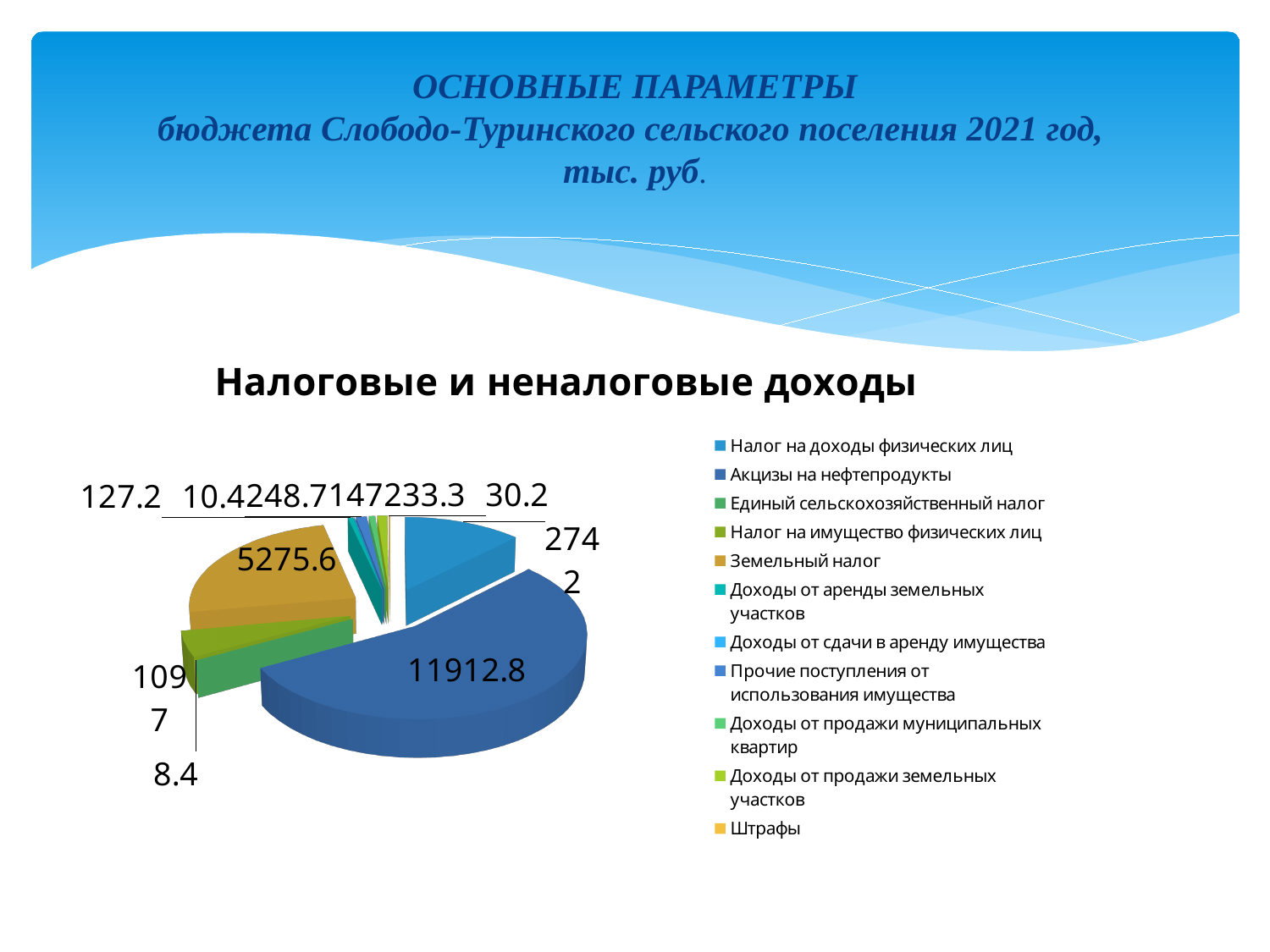
What is the value for Налог на доходы физических лиц? 2742 Which category has the largest slice of the pie? Акцизы на нефтепродукты How many categories does the chart legend list? 11 What is the difference between Земельный налог and Налог на доходы физических лиц? 2533.6 What is the largest value shown on the pie chart? 11912.8 What kind of chart is shown on the slide? Pie chart What is the value for Акцизы на нефтепродукты? 11912.8 What is the last entry in the chart legend? Штрафы What is the difference between Акцизы на нефтепродукты and Земельный налог? 6637.2 What is the value for Земельный налог? 5275.6 Which is larger: Земельный налог or Налог на доходы физических лиц? Земельный налог What is the title of the chart? Налоговые и неналоговые доходы